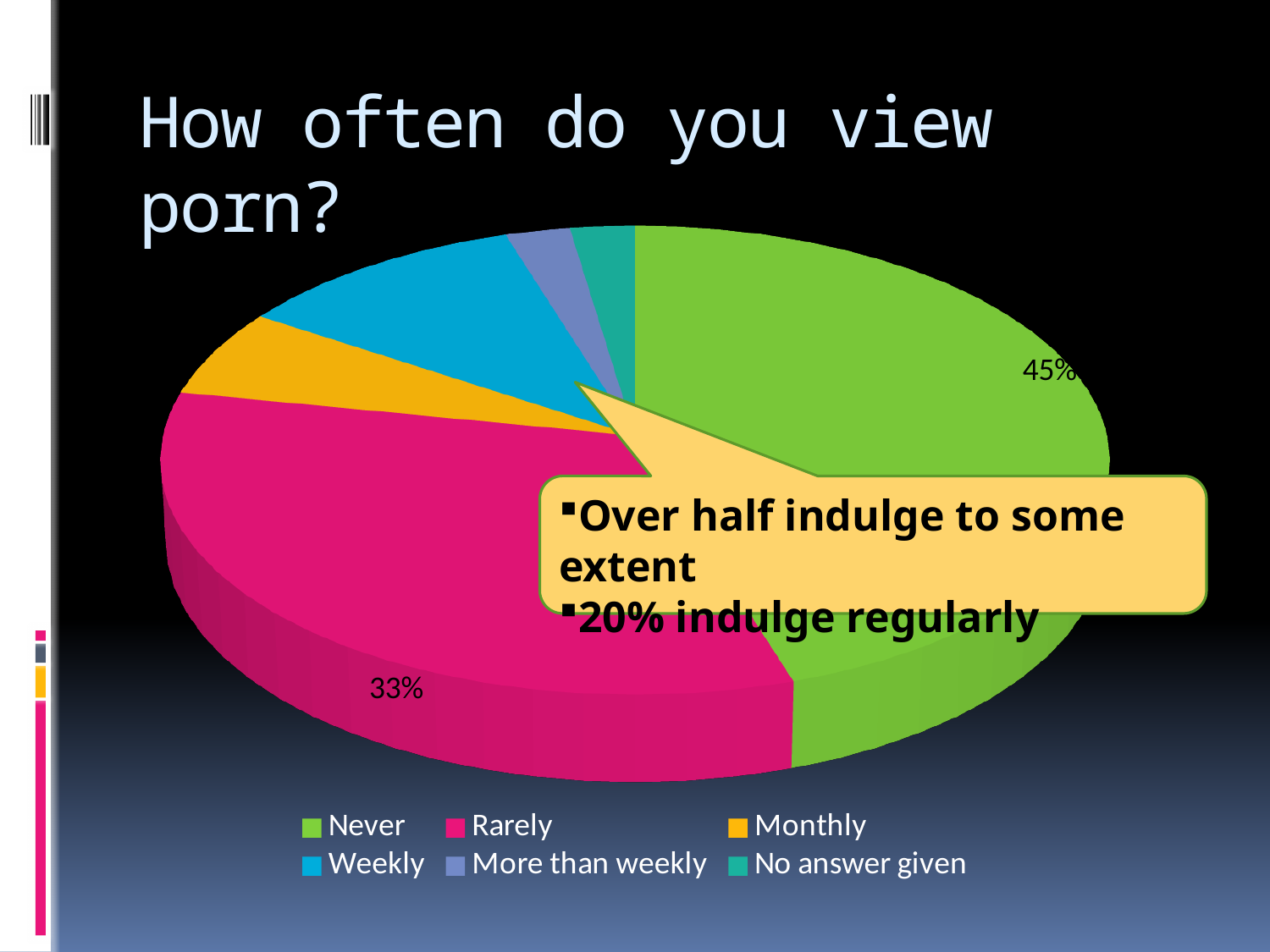
What colour is the "Never" slice in the pie chart? green Which category has the largest slice of the pie? Never Which is larger, the "Weekly" slice or the "Monthly" slice? Weekly Which is larger, the "Monthly" slice or the "More than weekly" slice? Monthly What percentage of respondents answered "Never"? 45% Which is larger, the "Never" slice or the "Rarely" slice? Never What is the title of the slide containing the pie chart? How often do you view porn? What kind of chart is shown on the slide? pie chart Is the "Never" slice greater or less than half of the pie? less What percentage of respondents answered "Rarely"? 33% What is the difference in percentage points between the "Never" and "Rarely" slices? 12 percentage points How many categories does the pie chart's legend list? 6